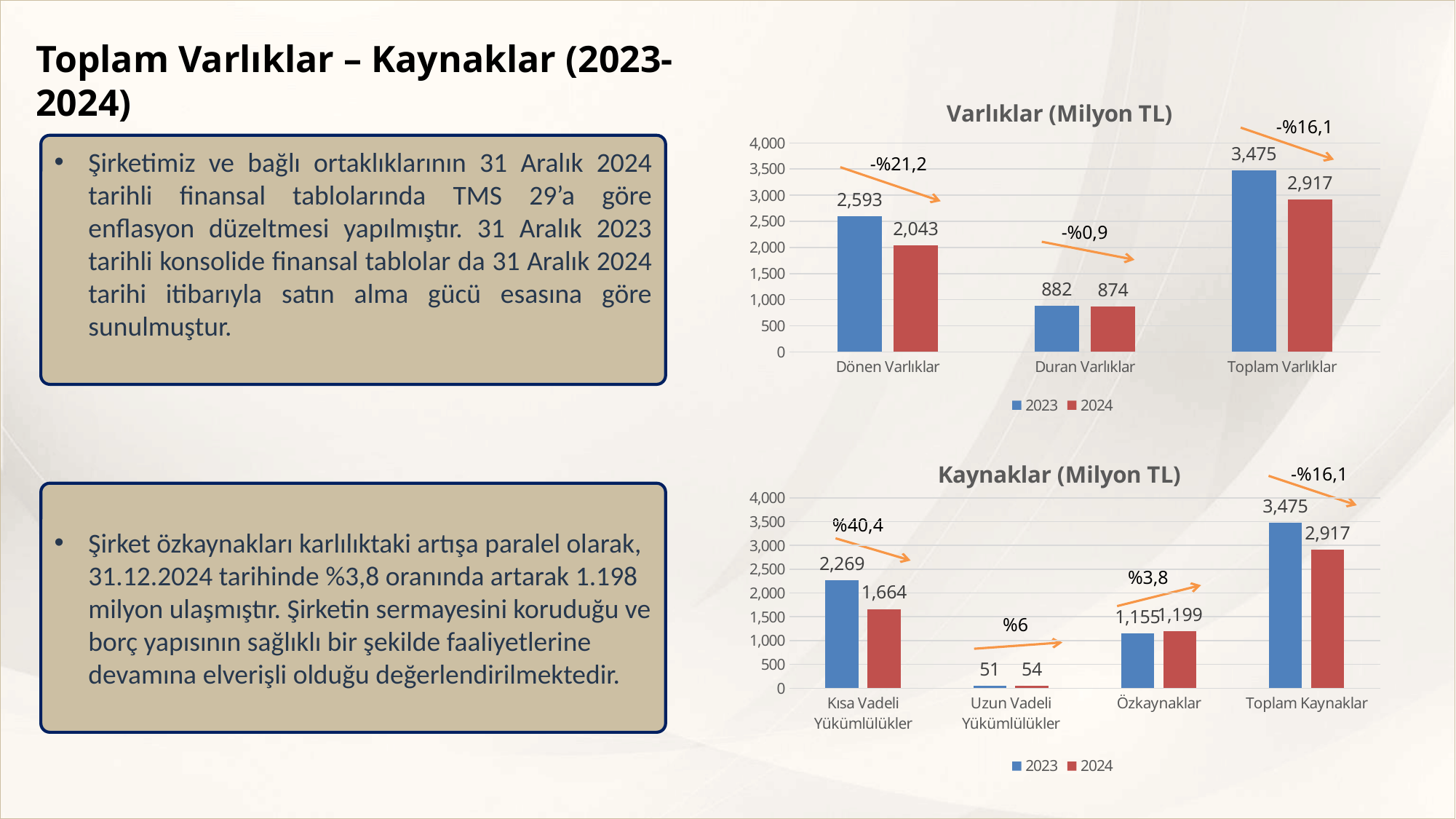
In the 'Varlıklar (Milyon TL)' chart, which category has the lowest 2024 value? Duran Varlıklar In the 'Varlıklar (Milyon TL)' chart, what is the 2024 value for Duran Varlıklar? 874 In the 'Kaynaklar (Milyon TL)' chart, which category has the lowest 2023 value? Uzun Vadeli Yükümlülükler In the 'Kaynaklar (Milyon TL)' chart, how many categories are shown on the x axis? 4 In the 'Varlıklar (Milyon TL)' chart, what is the 2023 value for Dönen Varlıklar? 2,593 In the 'Varlıklar (Milyon TL)' chart, what is the difference between the 2023 and 2024 values for Toplam Varlıklar? 558 In the 'Varlıklar (Milyon TL)' chart, how many series does the legend list? 2 In the 'Kaynaklar (Milyon TL)' chart, what is the 2024 value for Kısa Vadeli Yükümlülükler? 1,664 In the 'Kaynaklar (Milyon TL)' chart, what is the 2023 value for Özkaynaklar? 1,155 In the 'Kaynaklar (Milyon TL)' chart, what is the difference between the 2023 and 2024 values for Uzun Vadeli Yükümlülükler? 3 In the 'Kaynaklar (Milyon TL)' chart, is the 2024 value for Özkaynaklar larger or smaller than the 2023 value? larger What kind of chart is the 'Kaynaklar (Milyon TL)' chart? bar chart